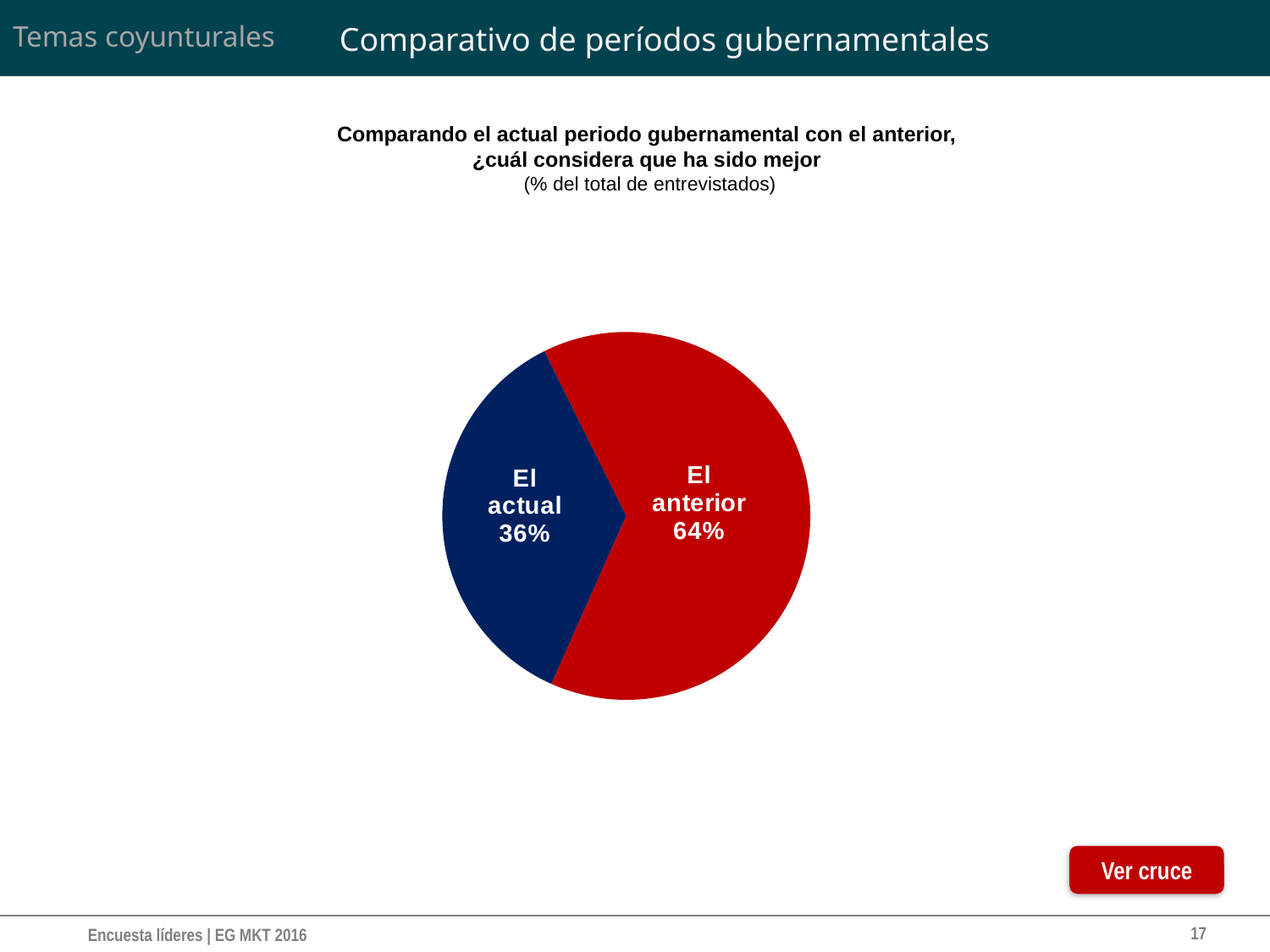
What percentage of respondents chose "El anterior"? 64% What percentage of respondents chose "El actual"? 36% Which slice of the pie is the largest? El anterior What colour is the "El actual" slice? dark blue What share of the pie does the "El anterior" slice represent? 64% How many slices does the pie chart have? 2 Which is larger, the share for "El actual" or the share for "El anterior"? El anterior What is the difference in percentage points between "El anterior" and "El actual"? 28 Which slice of the pie is the smallest? El actual What colour is the "El anterior" slice? red What kind of chart is shown on the slide? pie chart